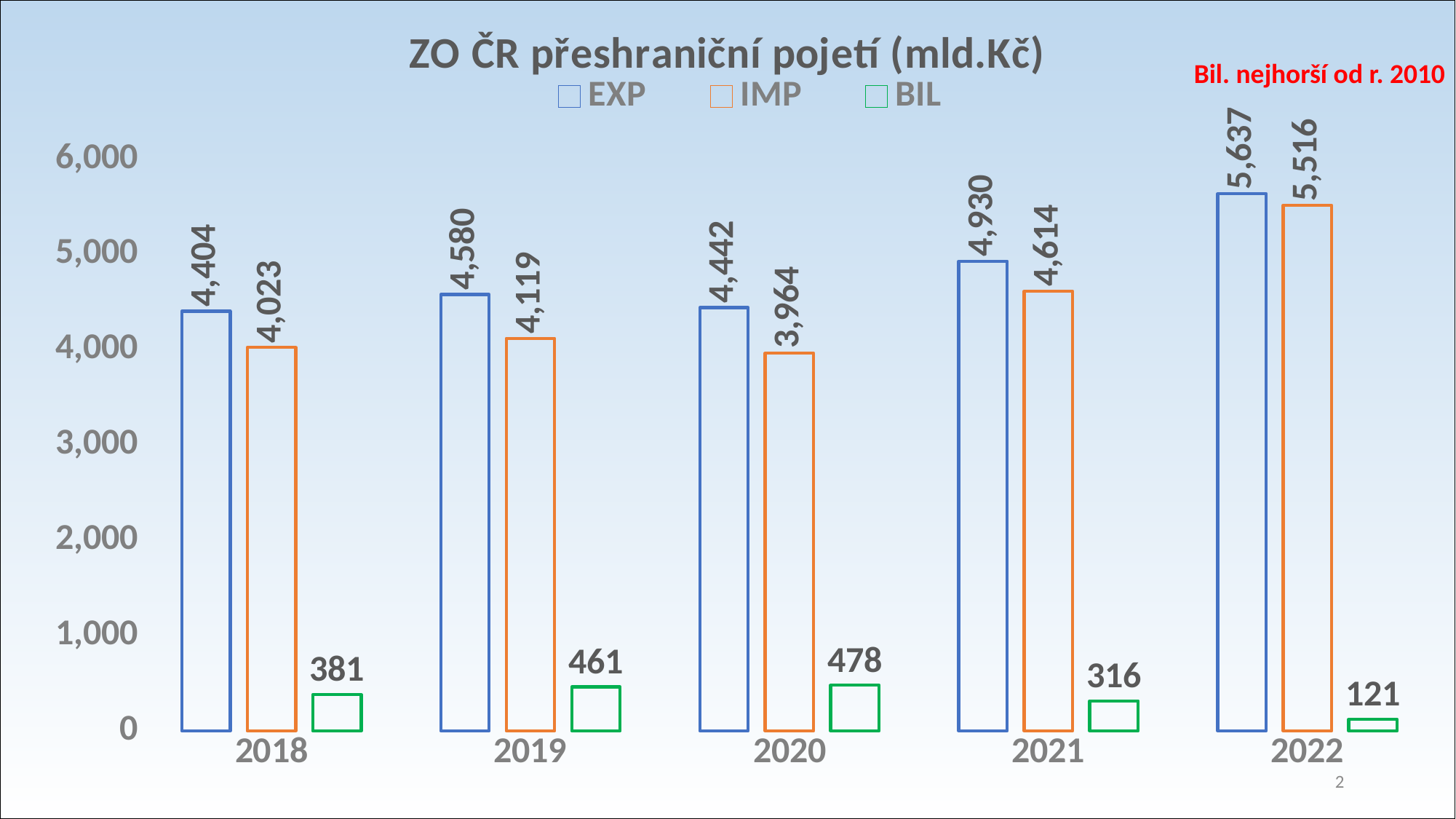
Which is larger, the IMP value for 2019 or the IMP value for 2020? IMP value for 2019 What is the IMP value for 2020? 3,964 Is the EXP value for 2021 greater or less than 5,000? less What is the difference between EXP and IMP in 2018? 381 What is the BIL value for 2021? 316 Which year has the lowest BIL value? 2022 What is the EXP value for 2022? 5,637 What kind of chart is shown on the slide? bar chart How many series does the legend list? 3 What is the title of the chart? ZO ČR přeshraniční pojetí (mld.Kč) How many years are shown on the x axis? 5 Which year has the highest EXP value? 2022